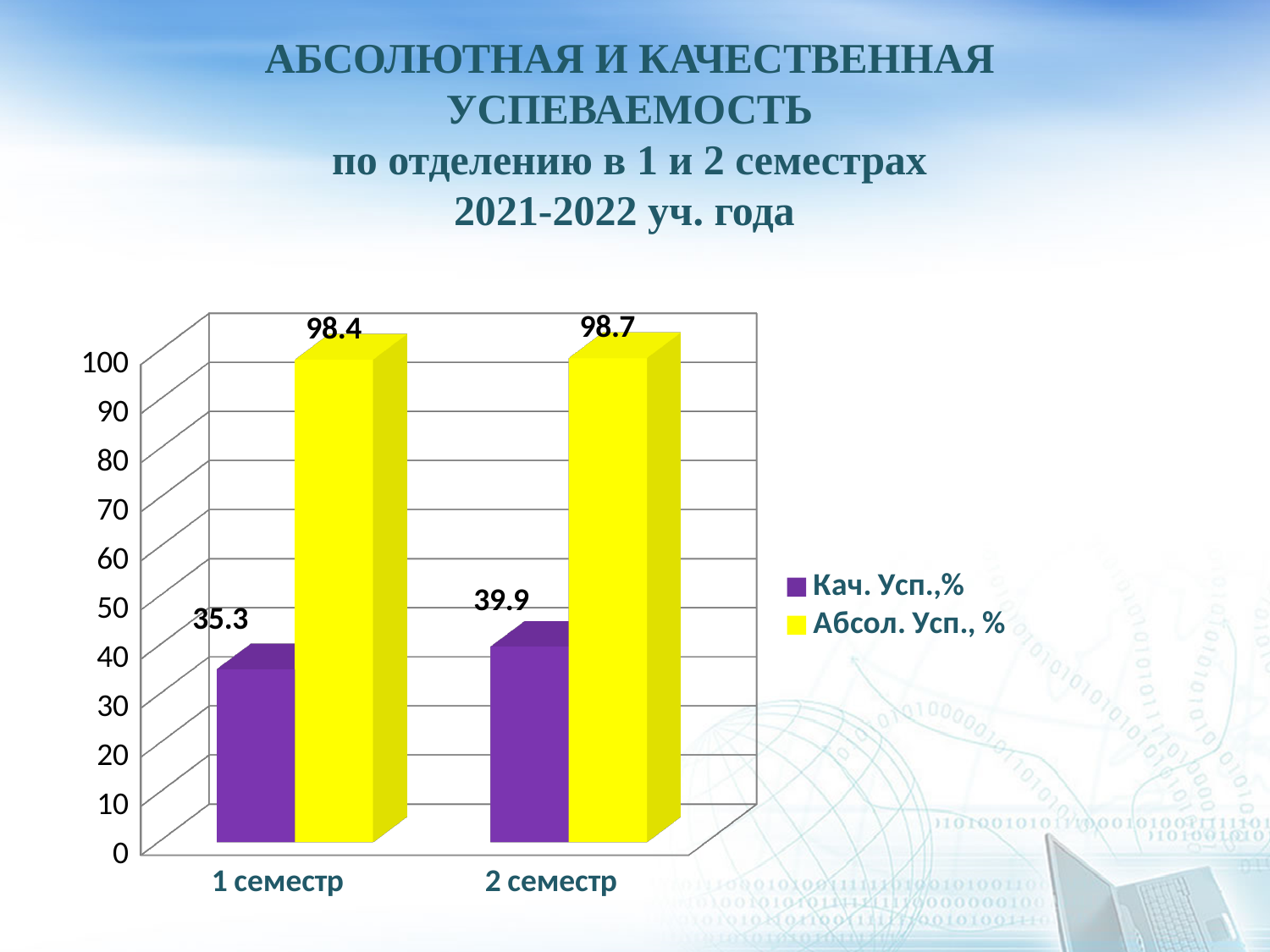
What is the value of Кач. Усп.,% for 2 семестр? 39.9 Is the value of Кач. Усп.,% for 2 семестр greater or less than 50? less What is the difference between the Абсол. Усп., % values for 2 семестр and 1 семестр? 0.3 Which semester has the higher value for Кач. Усп.,%? 2 семестр How many categories are shown on the x axis? 2 How many series does the legend list? 2 Which is larger for 1 семестр: Кач. Усп.,% or Абсол. Усп., %? Абсол. Усп., % What is the value of Кач. Усп.,% for 1 семестр? 35.3 What kind of chart is shown on the slide? bar chart What is the difference between the Кач. Усп.,% values for 2 семестр and 1 семестр? 4.6 What is the value of Абсол. Усп., % for 2 семестр? 98.7 What is the value of Абсол. Усп., % for 1 семестр? 98.4